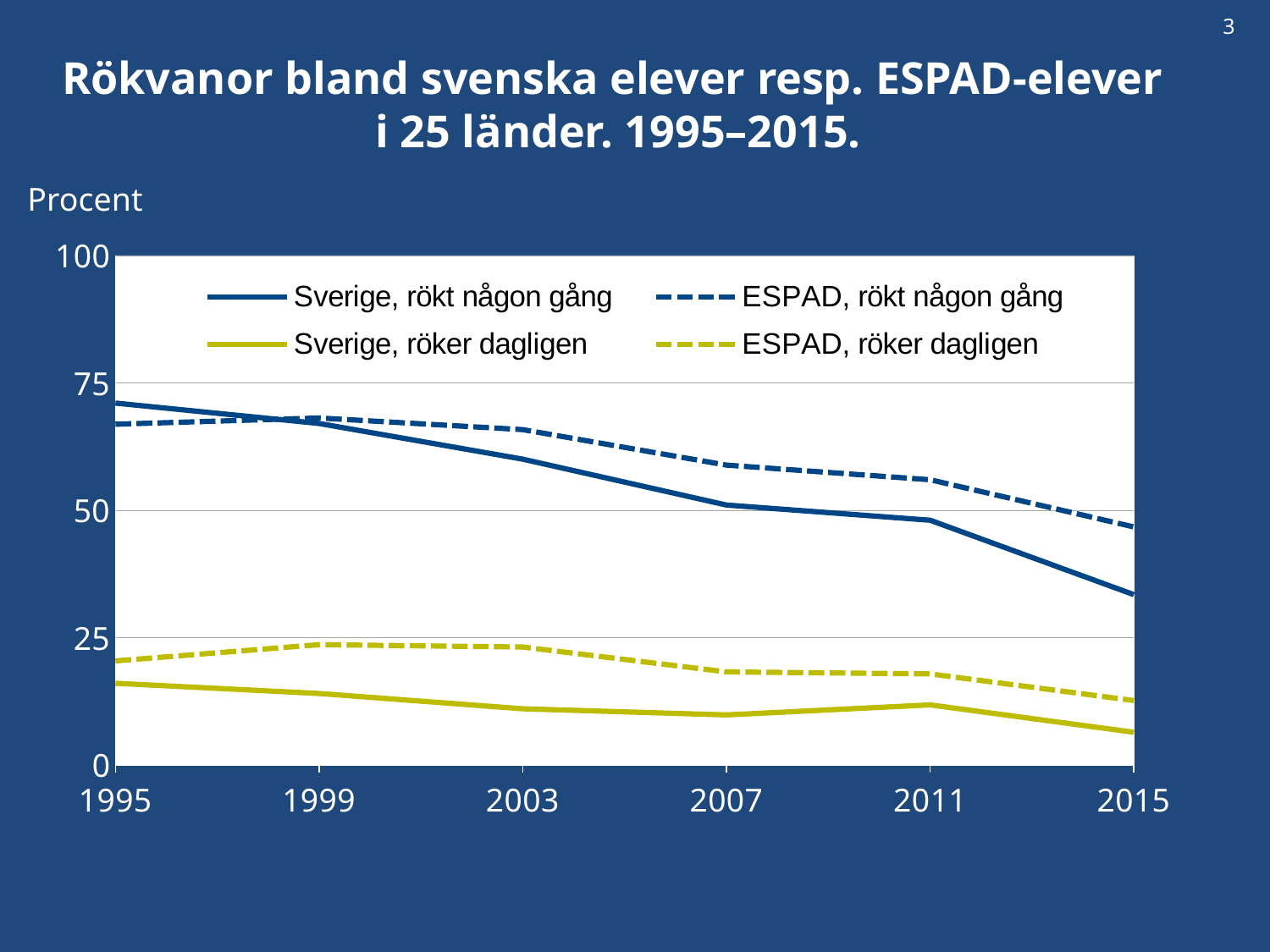
Does the line for 'Sverige, rökt någon gång' rise or fall from 1995 to 2015? fall Is the value for 'Sverige, röker dagligen' in 2015 greater or less than 25? less How many years are labelled on the x axis? 6 Does the line for 'ESPAD, rökt någon gång' rise or fall between 1999 and 2015? fall Is the value for 'Sverige, rökt någon gång' in 1995 greater or less than 50? greater What kind of chart is shown on the slide? line chart How many series does the legend list? 4 In which year is 'Sverige, rökt någon gång' at its highest? 1995 What unit is shown above the y axis of the chart? Procent In 2015, which is larger: 'ESPAD, rökt någon gång' or 'Sverige, rökt någon gång'? ESPAD, rökt någon gång In 2007, which is larger: 'ESPAD, röker dagligen' or 'Sverige, röker dagligen'? ESPAD, röker dagligen Is the value for 'Sverige, rökt någon gång' in 2015 greater or less than 50? less